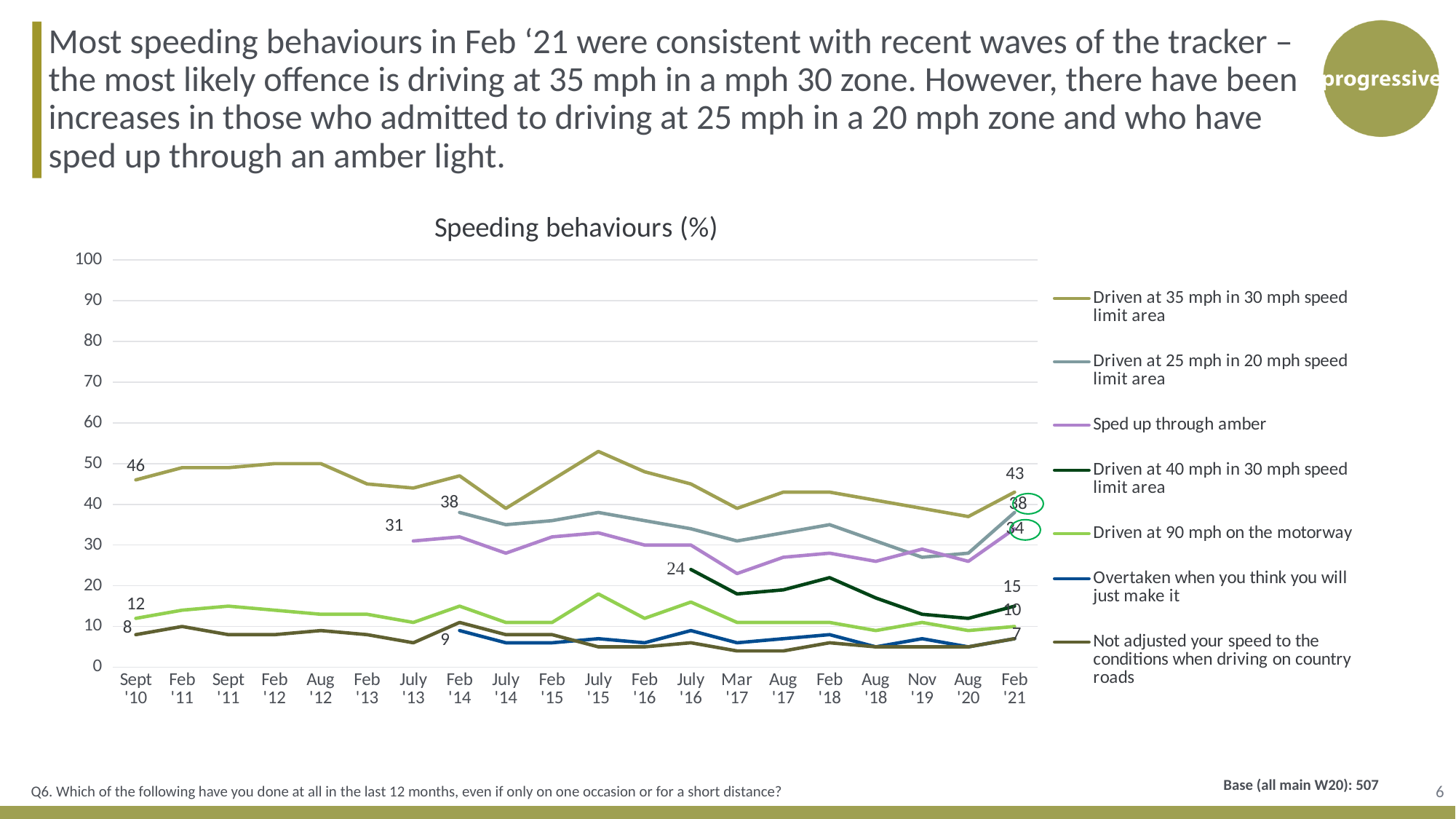
What is the difference between 'Driven at 35 mph in 30 mph speed limit area' and 'Driven at 25 mph in 20 mph speed limit area' in Feb '21? 5 Is the value for 'Driven at 35 mph in 30 mph speed limit area' in July '15 greater or less than 50? greater What is the value for 'Driven at 40 mph in 30 mph speed limit area' in July '16? 24 What is the value for 'Sped up through amber' in July '13? 31 Did the value for 'Driven at 40 mph in 30 mph speed limit area' rise or fall between July '16 and Feb '21? Fall Which series has the highest value in Feb '21? Driven at 35 mph in 30 mph speed limit area What is the value for 'Driven at 35 mph in 30 mph speed limit area' in Feb '21? 43 How many series does the legend list? 7 What kind of chart is shown on the slide? Line chart What is the value for 'Driven at 90 mph on the motorway' in Sept '10? 12 How many time points are shown on the x axis? 20 What is the value for 'Driven at 25 mph in 20 mph speed limit area' in Feb '21? 38